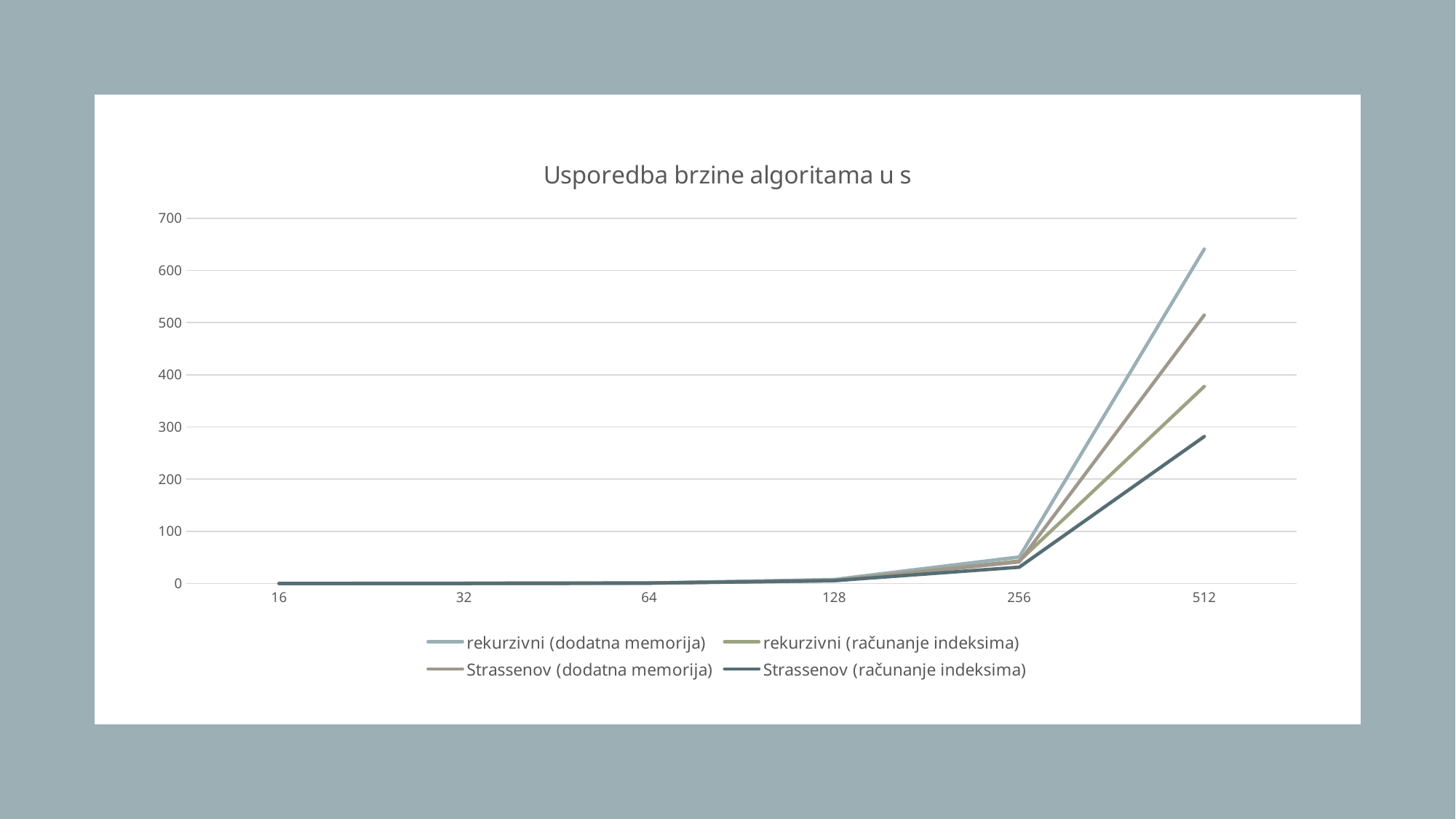
Is the value for Strassenov (dodatna memorija) at 512 greater or less than 300? greater How many series does the legend list? 4 What is the title of the chart? Usporedba brzine algoritama u s How many points are there along the x axis? 6 Do the values for rekurzivni (dodatna memorija) rise or fall from 16 to 512? rise What kind of chart is shown on the slide? line chart Is the value for Strassenov (računanje indeksima) at 512 greater or less than 300? less Which series has the highest value at 512? rekurzivni (dodatna memorija) Which series has the lowest value at 512? Strassenov (računanje indeksima) Is the value for rekurzivni (dodatna memorija) at 256 greater or less than 100? less At 512, which is larger: rekurzivni (dodatna memorija) or Strassenov (računanje indeksima)? rekurzivni (dodatna memorija)